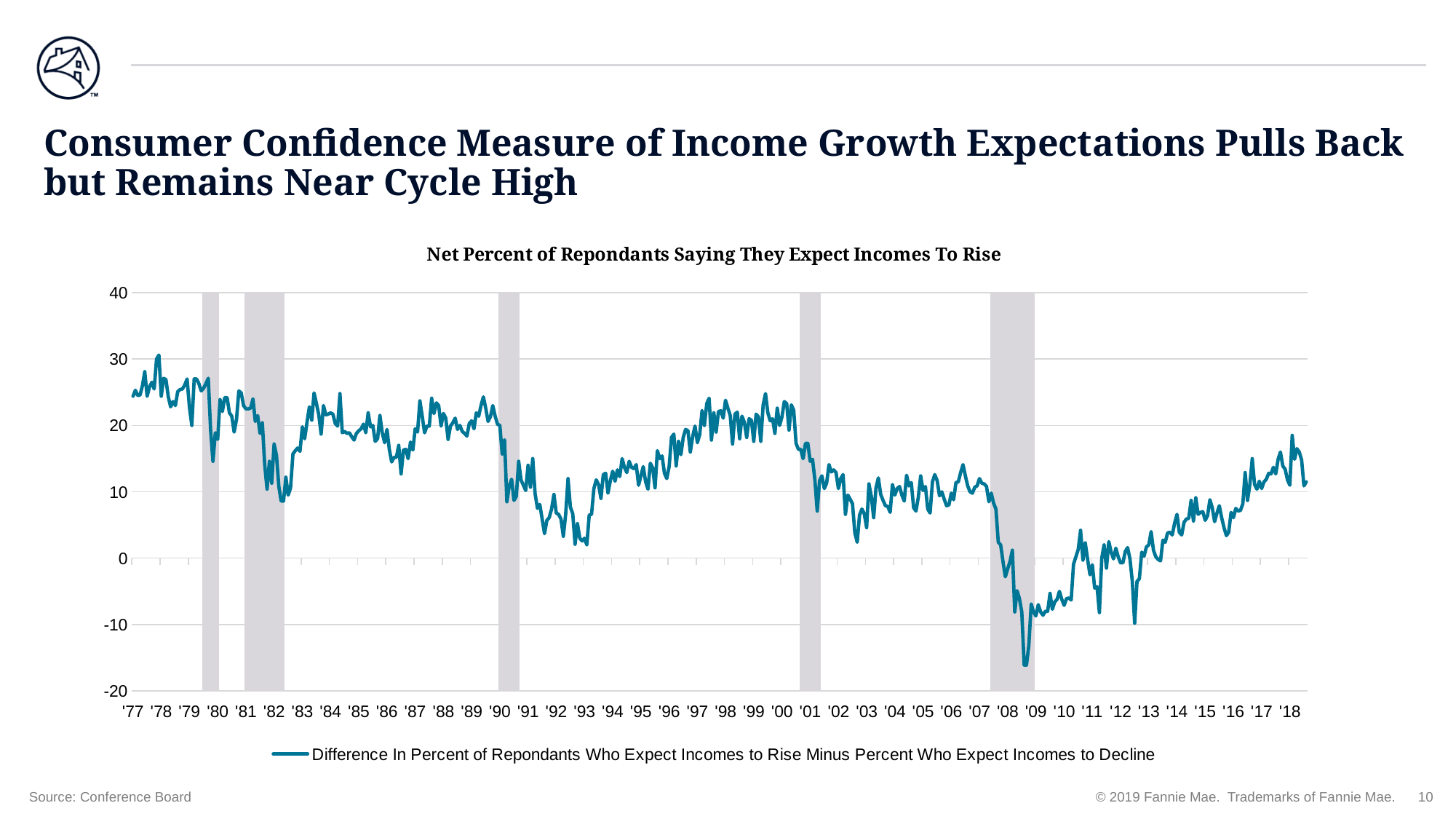
What is the title of the chart? Net Percent of Repondants Saying They Expect Incomes To Rise Is the value around '93 greater or less than 10? less How many series does the legend list? 1 Does the line generally rise or fall from 2009 to 2018? rise Does the line generally rise or fall from 2000 to 2003? fall What is the legend entry for the plotted line? Difference In Percent of Repondants Who Expect Incomes to Rise Minus Percent Who Expect Incomes to Decline Is the value at the end of the series in '18 greater or less than 20? less Is the lowest value the line reaches around 2009 greater or less than -10? less Which is larger, the value around '78 or the value around '09? '78 Around which year does the line reach its highest value? '78 What kind of chart is shown on the slide? line chart